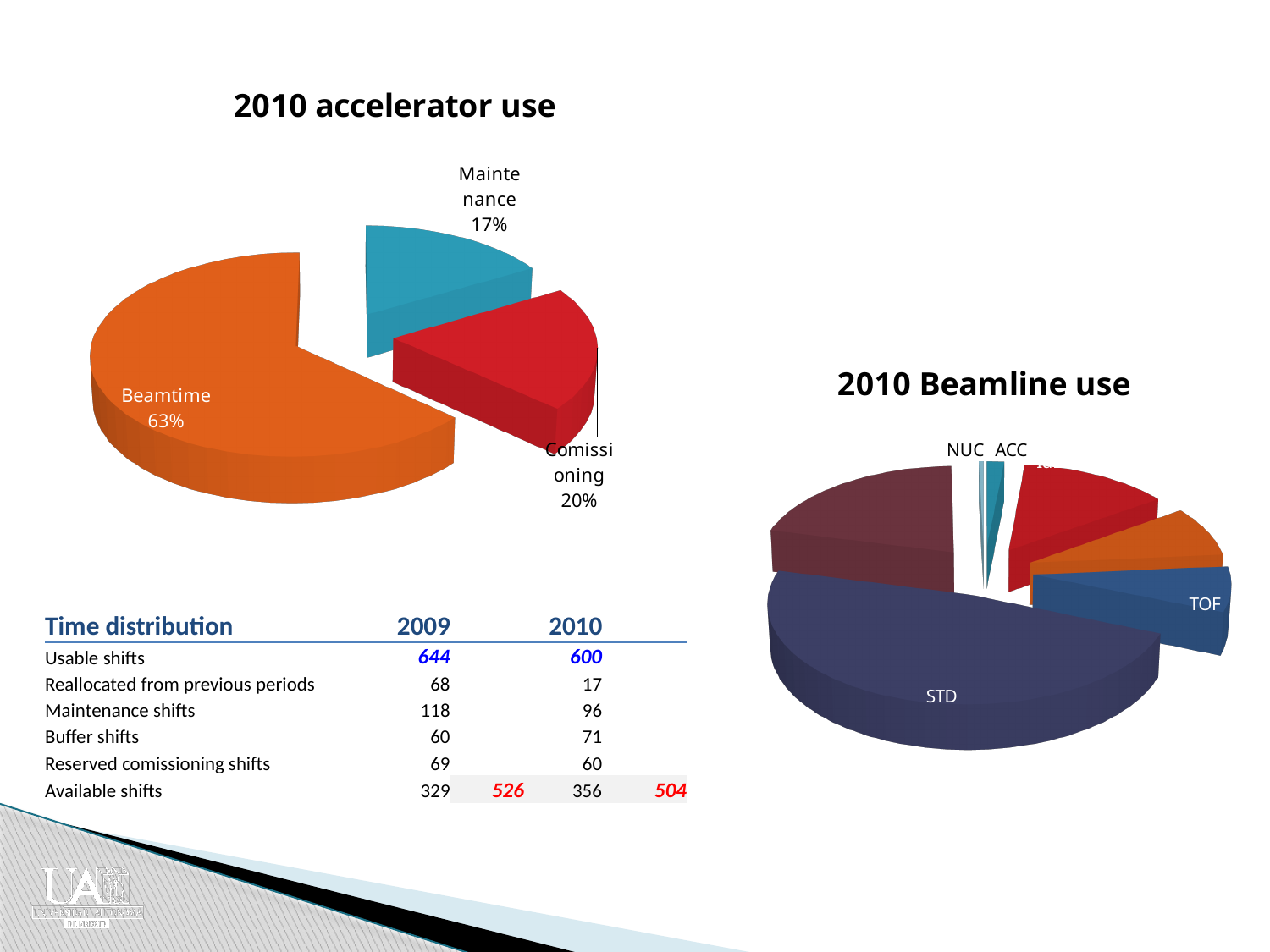
In the '2010 accelerator use' chart, which category has the smallest share? Maintenance In the '2010 Beamline use' chart, which slice is the largest? STD In the '2010 accelerator use' chart, what percentage is labelled Comissioning? 20% In the '2010 accelerator use' chart, how many percentage points larger is Beamtime than Comissioning? 43 In the '2010 accelerator use' chart, what percentage is labelled Maintenance? 17% In the '2010 accelerator use' chart, which is larger, Comissioning or Maintenance? Comissioning How many slices does the '2010 accelerator use' pie chart have? 3 In the '2010 Beamline use' chart, which is larger, STD or TOF? STD What is the title of the pie chart on the right side of the slide? 2010 Beamline use What type of chart is the '2010 accelerator use' chart? Pie chart In the '2010 accelerator use' chart, what share of the pie is Beamtime? 63% In the '2010 accelerator use' chart, which category has the largest share? Beamtime